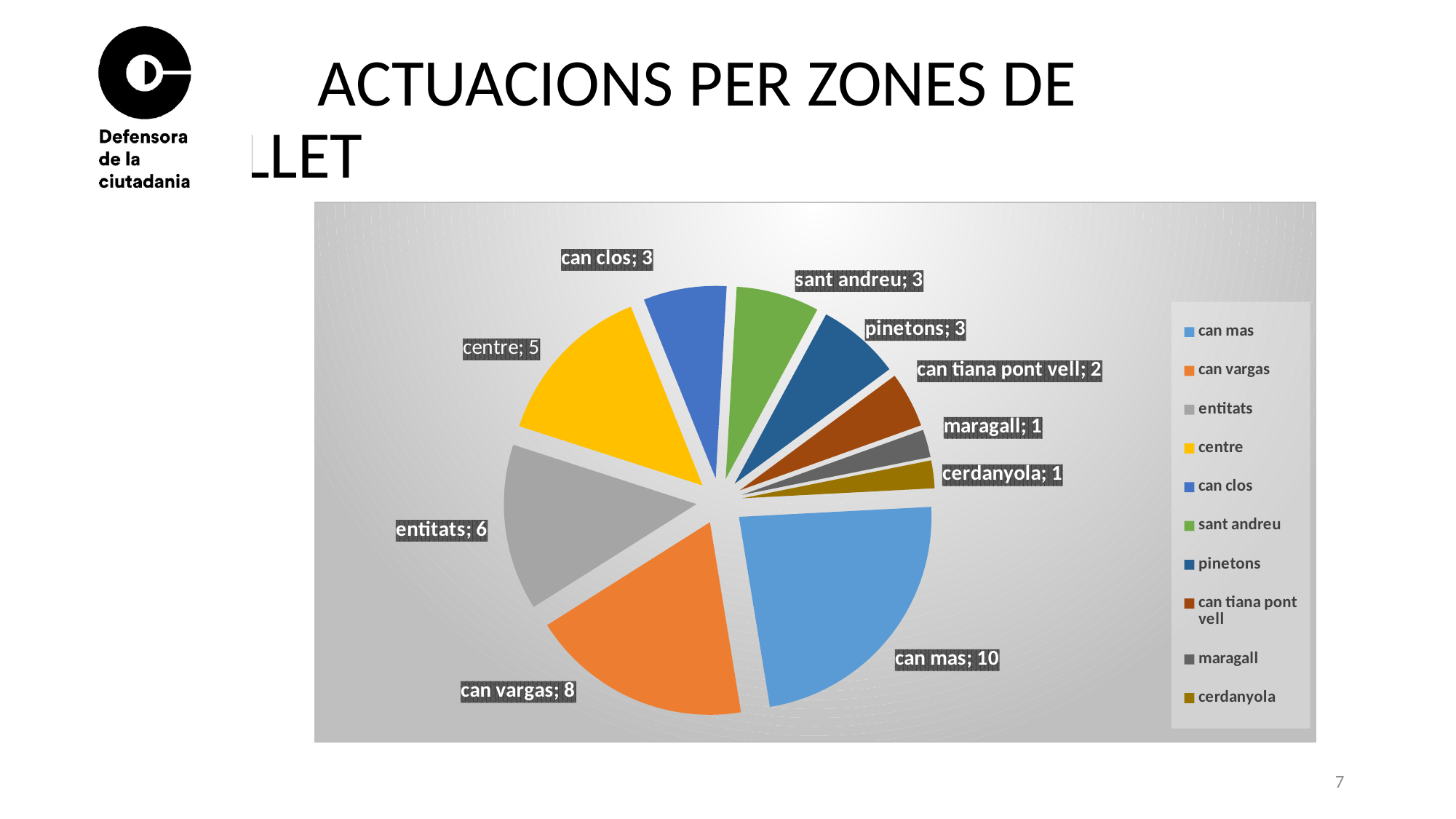
What is the value for can vargas? 8 What is the value for entitats? 6 How many entries does the legend list? 10 Which is larger, the value for centre or the value for entitats? entitats What is the value for can mas? 10 How many slices does the pie chart have? 10 Which zones share the smallest value in the pie? maragall and cerdanyola What kind of chart is shown on the slide? pie chart What is the difference between the values for can mas and can vargas? 2 What is the total of all the slice values in the pie chart? 42 What is the value for can tiana pont vell? 2 Which zone has the largest slice of the pie? can mas